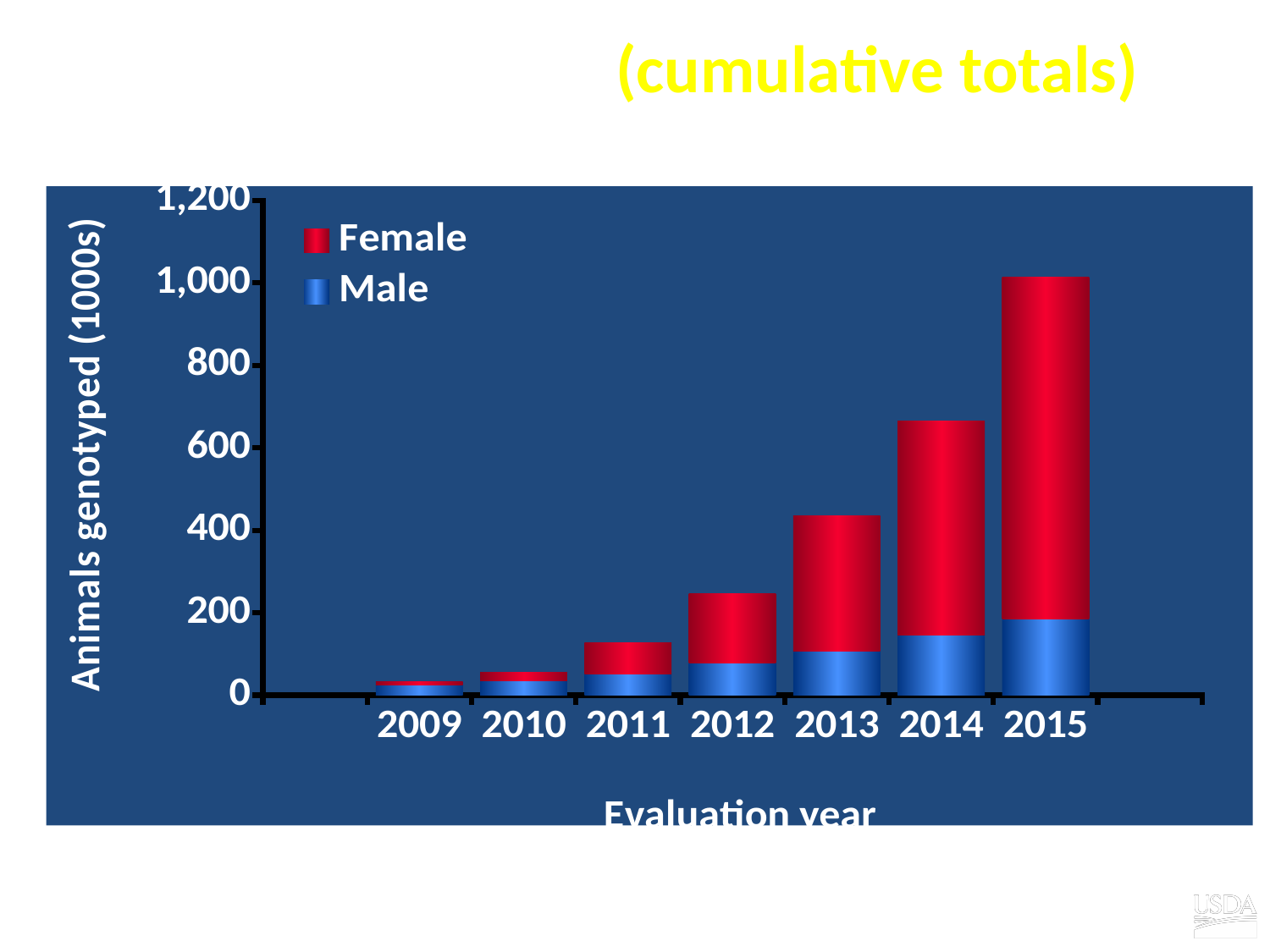
Is the total value for 2014 greater or less than 600? greater How many series does the legend list? 2 How many evaluation years are shown on the x axis? 7 Is the total value for 2011 greater or less than 200? less Is the total value for 2015 greater or less than 800? greater Which evaluation year has the highest total of animals genotyped? 2015 Do the total animals genotyped rise or fall from 2009 to 2015? rise In 2015, which is larger, the Female segment or the Male segment? Female Which series is shown in red in the legend? Female What kind of chart is shown on the slide? stacked bar chart What is the label on the y axis? Animals genotyped (1000s) Which evaluation year has the lowest total of animals genotyped? 2009